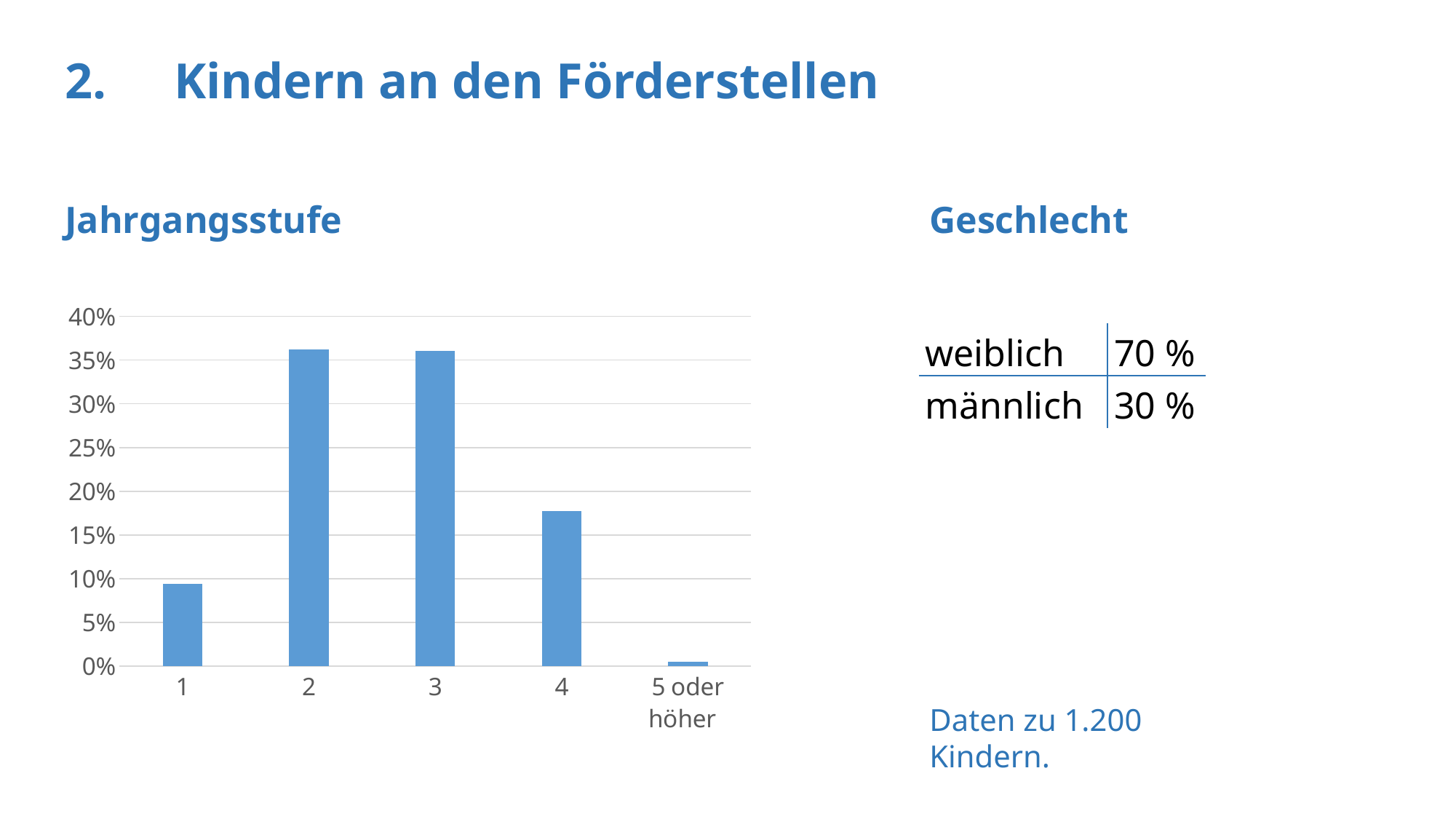
Is the value for Jahrgangsstufe 1 greater or less than 10%? less Which is larger in the Jahrgangsstufe chart, the value for 2 or the value for 4? 2 How many categories are shown on the x axis of the Jahrgangsstufe chart? 5 Is the value for "5 oder höher" greater or less than 5%? less What is the highest tick value shown on the y axis of the Jahrgangsstufe chart? 40% Is the value for Jahrgangsstufe 4 greater or less than 20%? less Which is larger in the Jahrgangsstufe chart, the value for 1 or the value for 4? 4 What kind of chart is shown under the heading "Jahrgangsstufe"? bar chart What is the label of the last category on the x axis of the Jahrgangsstufe chart? 5 oder höher Which category has the lowest value in the Jahrgangsstufe chart? 5 oder höher